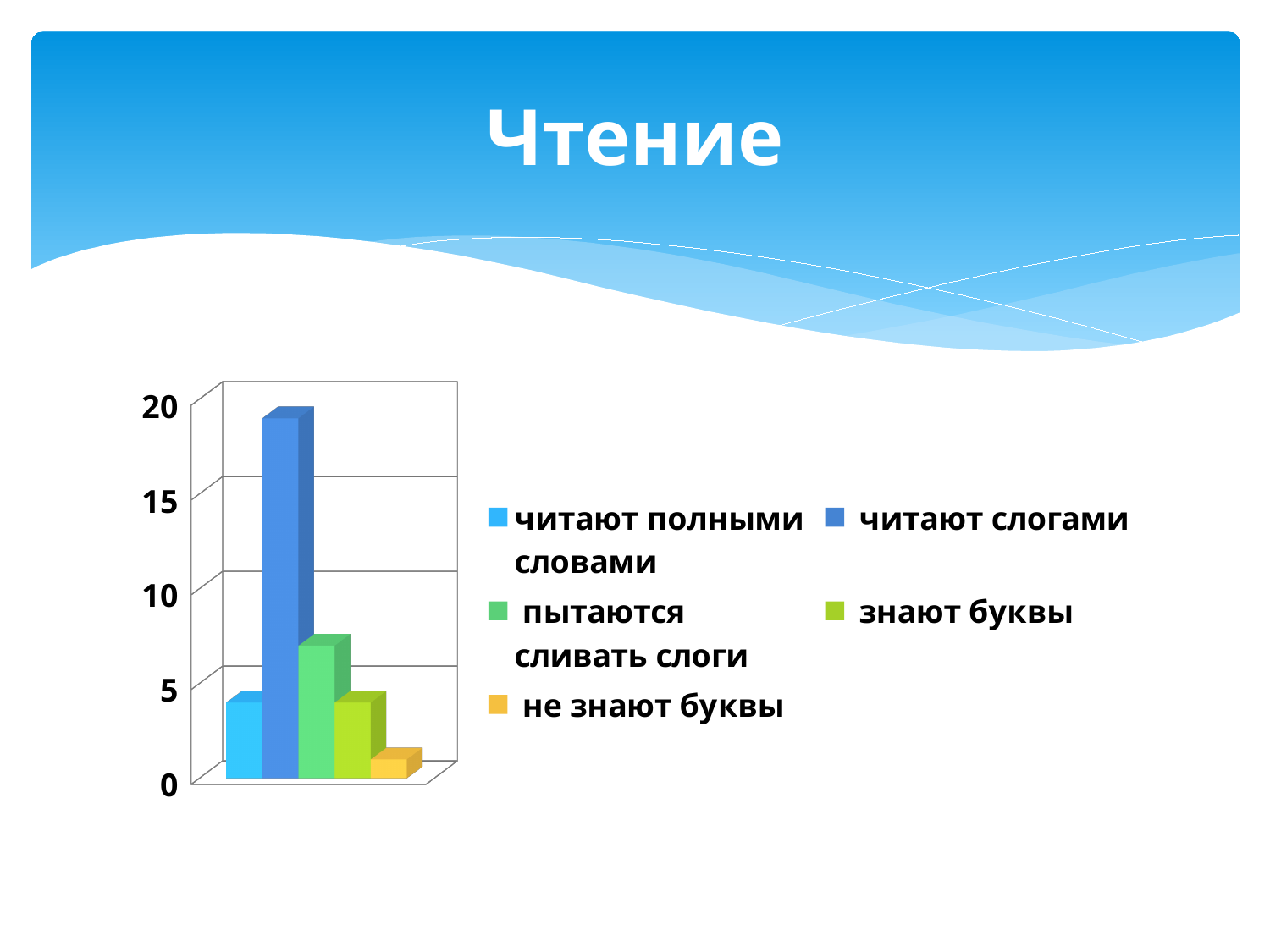
Is the value for "пытаются сливать слоги" greater or less than 10? less Is the value for "пытаются сливать слоги" greater or less than 5? greater What is the title of the slide containing the chart? Чтение How many bars are plotted in the chart? 5 Is the value for "читают слогами" greater or less than 15? greater How many series does the chart legend list? 5 Which series has the lowest bar in the chart? не знают буквы Which is larger, the value for "пытаются сливать слоги" or the value for "не знают буквы"? пытаются сливать слоги What kind of chart is shown on the slide? bar chart Which is larger, the value for "читают слогами" or the value for "пытаются сливать слоги"? читают слогами Which series has the highest bar in the chart? читают слогами